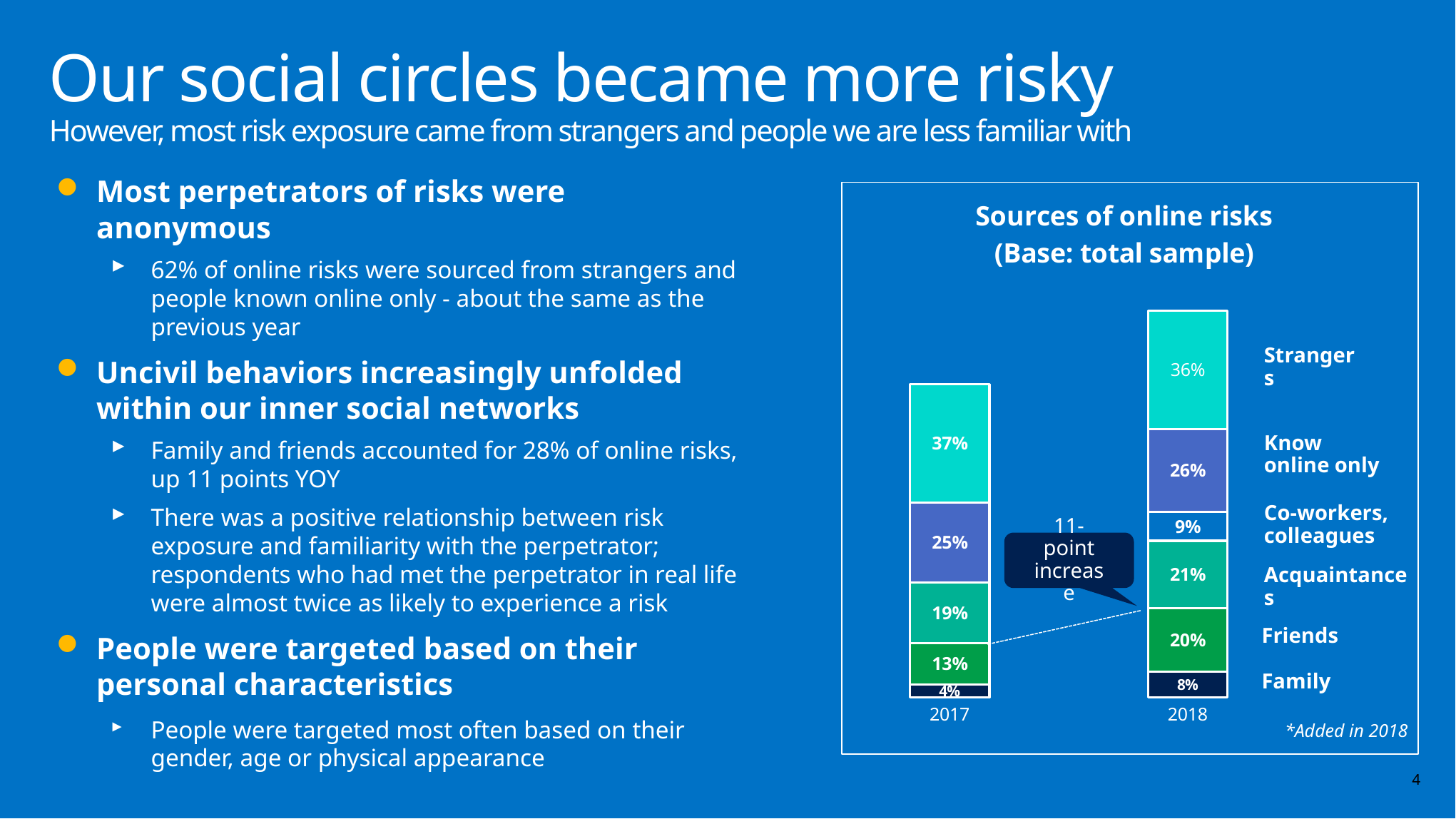
In the Sources of online risks chart, which source has the smallest share in 2018? Family In the Sources of online risks chart, what percentage is shown for Friends in 2017? 13% How many years are shown on the x axis of the Sources of online risks chart? 2 How many source categories does the legend of the Sources of online risks chart list? 6 In the Sources of online risks chart, what percentage is shown for Co-workers, colleagues in 2018? 9% In the Sources of online risks chart, by how many percentage points did the Friends share change from 2017 to 2018? 7 percentage points In the Sources of online risks chart, what share of online risks came from Strangers in 2018? 36% In the Sources of online risks chart, which year has the larger Strangers share, 2017 or 2018? 2017 In the Sources of online risks chart, which source has the largest share in 2017? Strangers What kind of chart is the Sources of online risks chart? Stacked bar chart In the Sources of online risks chart, what percentage is shown for Family in 2018? 8% In the Sources of online risks chart, by how many percentage points did the Family share change from 2017 to 2018? 4 percentage points